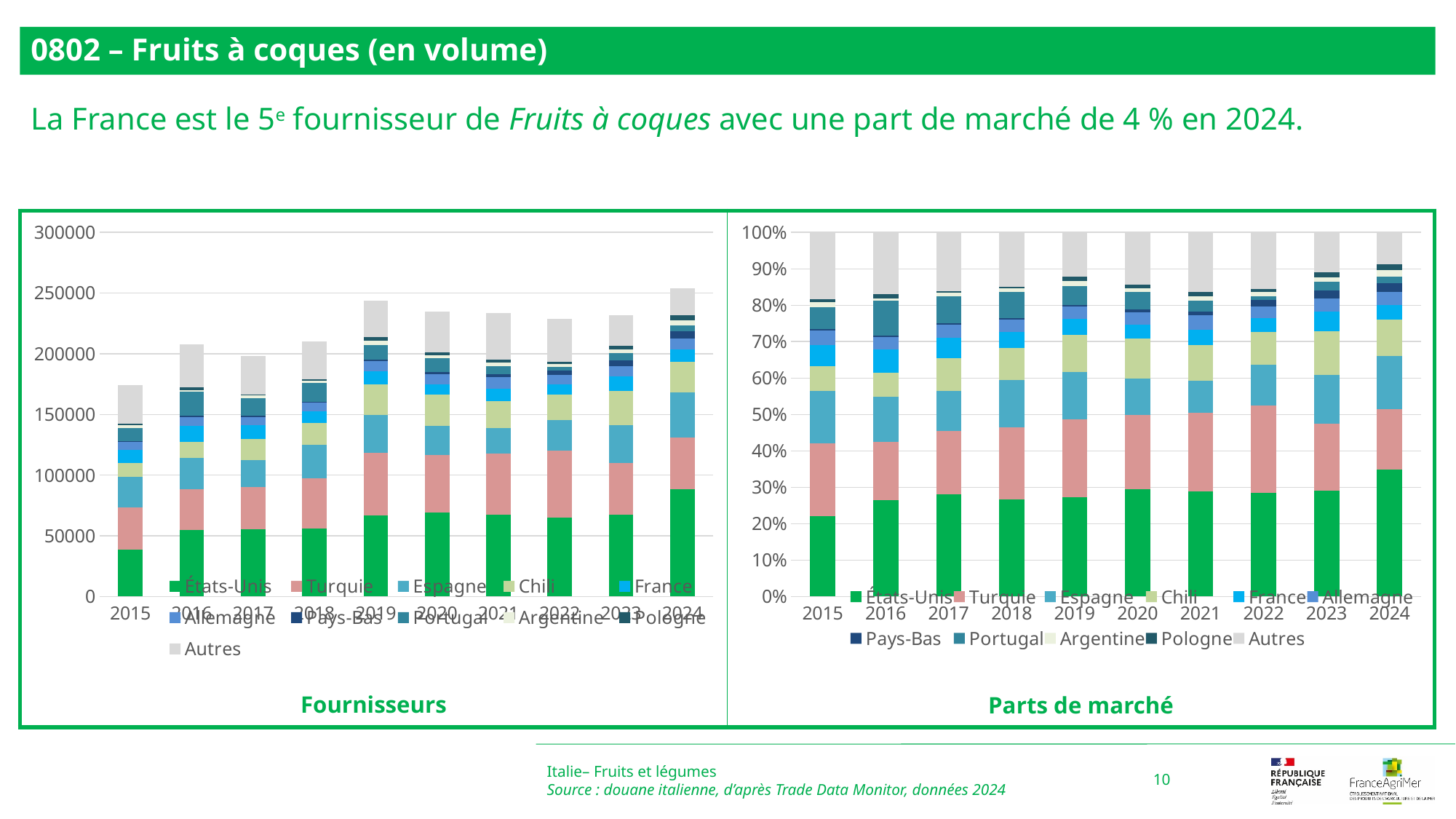
In the 'Fournisseurs' chart, is the value for États-Unis in 2024 greater or less than 50000? greater How many years are shown on the x axis of the 'Parts de marché' chart? 10 In the 'Parts de marché' chart, is the share of États-Unis larger in 2015 or in 2024? 2024 In the 'Fournisseurs' chart, is the total for 2019 greater or less than 200000? greater What kind of chart is the 'Fournisseurs' chart on the left? stacked bar chart In the 'Parts de marché' chart, which series is shown in grey at the top of each bar? Autres In the 'Fournisseurs' chart, which year has the highest total stacked bar? 2024 In the 'Fournisseurs' chart, which year has the lowest total stacked bar? 2015 In the 'Parts de marché' chart, is the share of États-Unis in 2015 greater or less than 30%? less How many series does the legend of the 'Fournisseurs' chart list? 11 In the 'Parts de marché' chart, does the share of États-Unis rise or fall between 2015 and 2024? rise